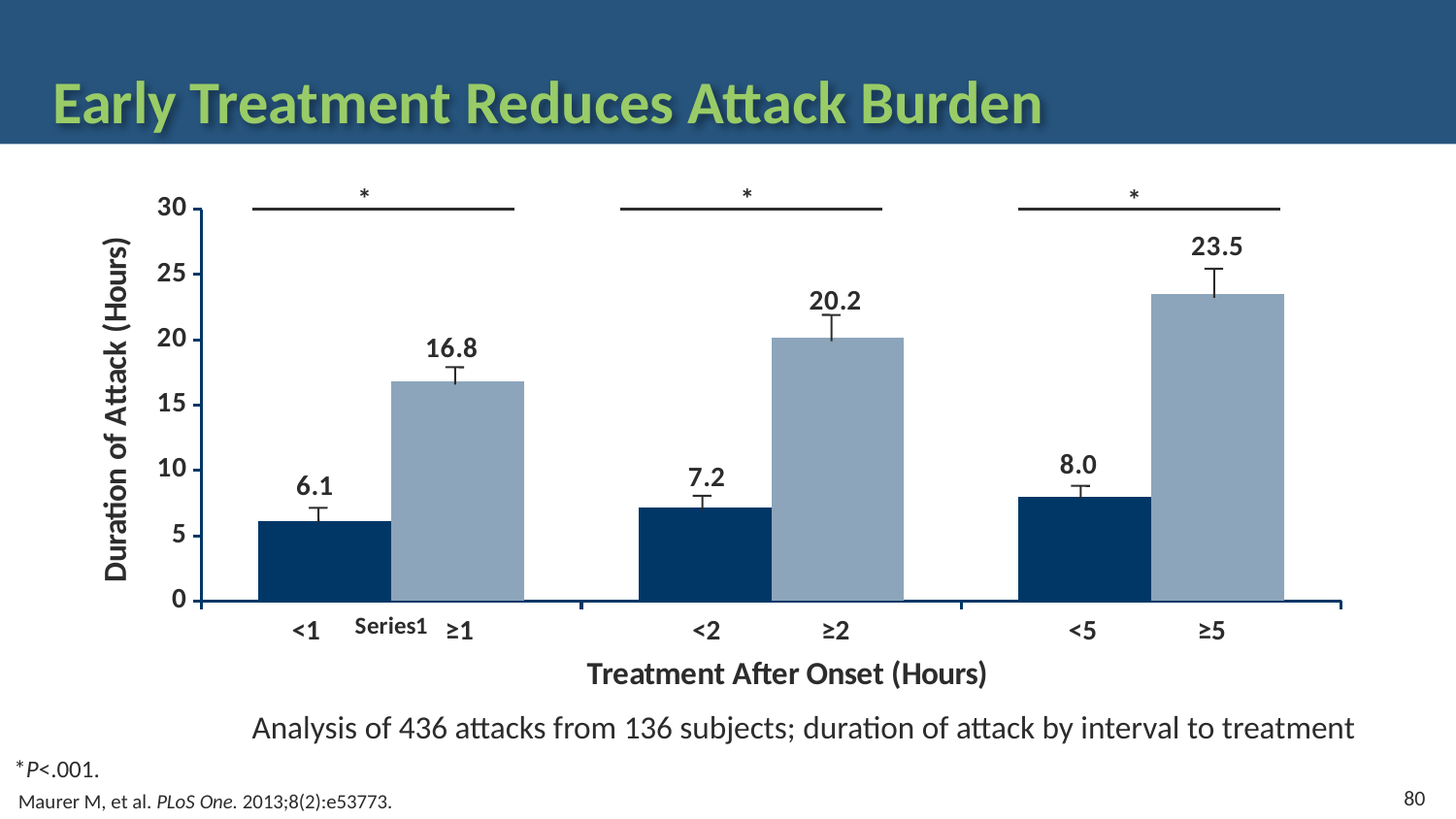
Which treatment interval has the shortest duration of attack? <1 What is the label of the y axis? Duration of Attack (Hours) How many bars are plotted in the chart? 6 Which treatment interval has the longest duration of attack? ≥5 What is the duration of attack for treatment at <1 hour after onset? 6.1 What is the difference in duration of attack between treatment at ≥5 hours and <5 hours? 15.5 What is the difference in duration of attack between treatment at ≥1 hour and <1 hour? 10.7 Which has a longer duration of attack: treatment at <2 hours or ≥2 hours? ≥2 What is the duration of attack for treatment at ≥5 hours after onset? 23.5 What is the duration of attack for treatment at ≥2 hours after onset? 20.2 What type of chart is shown on the slide? Bar chart What is the duration of attack for treatment at <5 hours after onset? 8.0